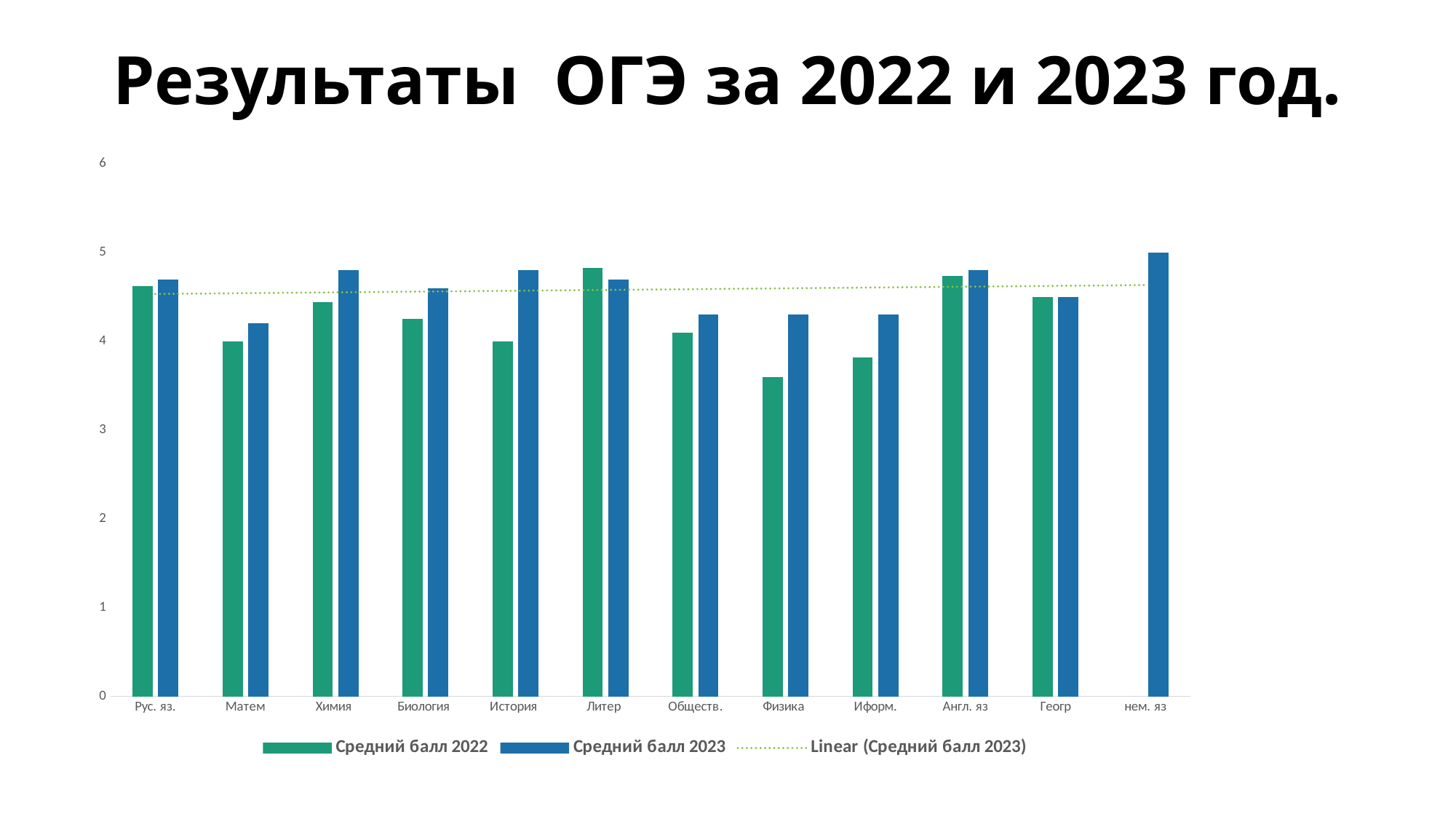
Which subject has the lowest value for Средний балл 2022? Физика For История, which series has the larger value: Средний балл 2022 or Средний балл 2023? Средний балл 2023 How many entries does the legend list? 3 Is the value for Иформ. in Средний балл 2022 greater or less than 4? less For Физика, which series has the larger value: Средний балл 2022 or Средний балл 2023? Средний балл 2023 What kind of chart is shown on the slide? bar chart Is the value for Физика in Средний балл 2022 greater or less than 4? less What is the title of the slide? Результаты ОГЭ за 2022 и 2023 год. How many subject categories are shown on the x axis? 12 Which colour represents Средний балл 2023 in the legend? blue Is the value for Химия in Средний балл 2023 greater or less than 4? greater Which subject has the highest value for Средний балл 2023? нем. яз